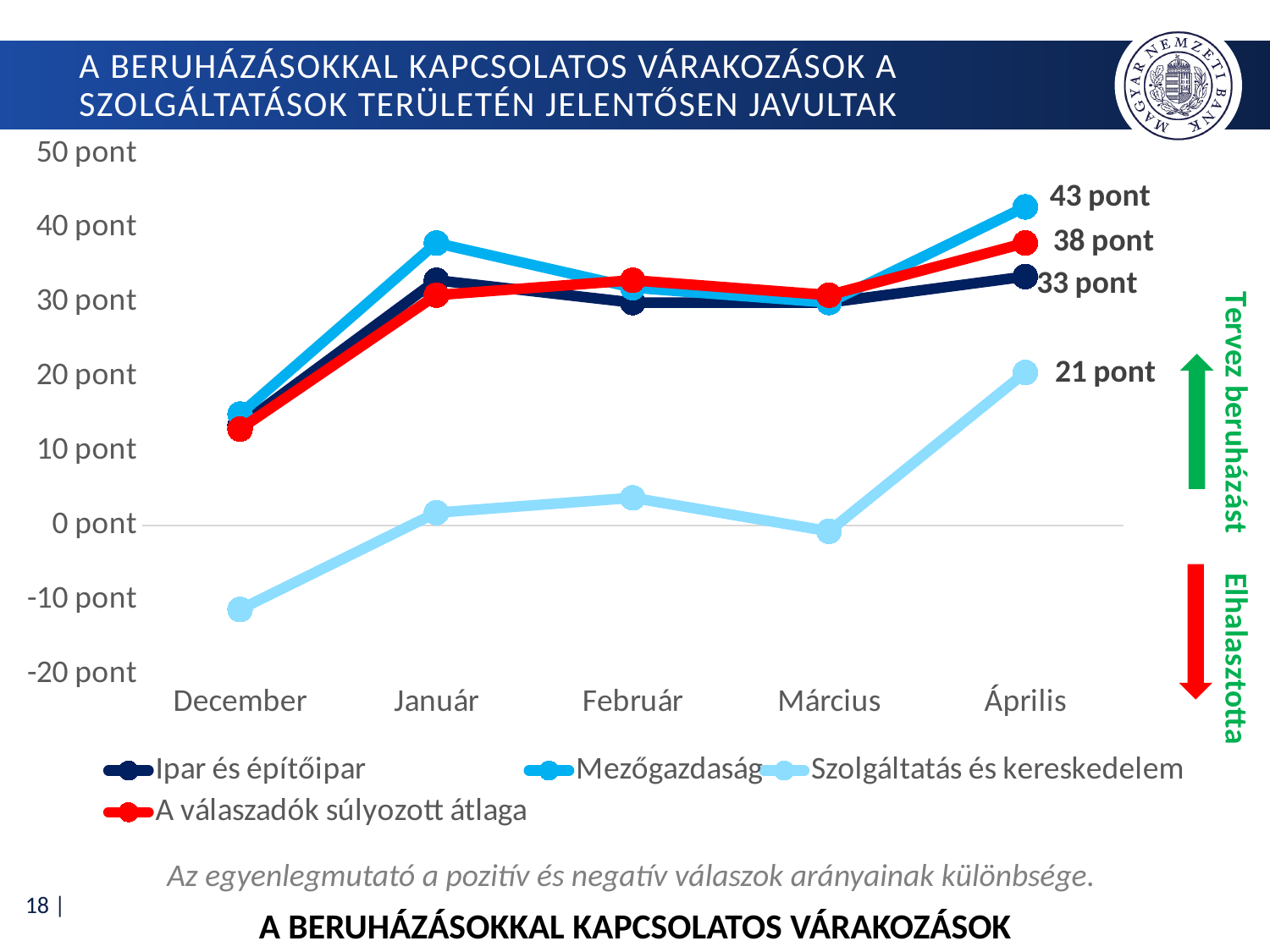
How many series does the legend list? 4 Which series has the highest value in Április? Mezőgazdaság Is the value for Mezőgazdaság in Január greater or less than 30 pont? greater What kind of chart is shown on the slide? line chart How many months are shown on the x axis? 5 What is the value for Szolgáltatás és kereskedelem in Április? 21 pont Is the value for Szolgáltatás és kereskedelem in December greater or less than 0 pont? less Does the Szolgáltatás és kereskedelem series rise or fall from December to Április? rise Which series has the lowest value in Április? Szolgáltatás és kereskedelem What is the value for Mezőgazdaság in Április? 43 pont What is the difference between the Április values of Mezőgazdaság and Szolgáltatás és kereskedelem? 22 pont What is the value for A válaszadók súlyozott átlaga in Április? 38 pont